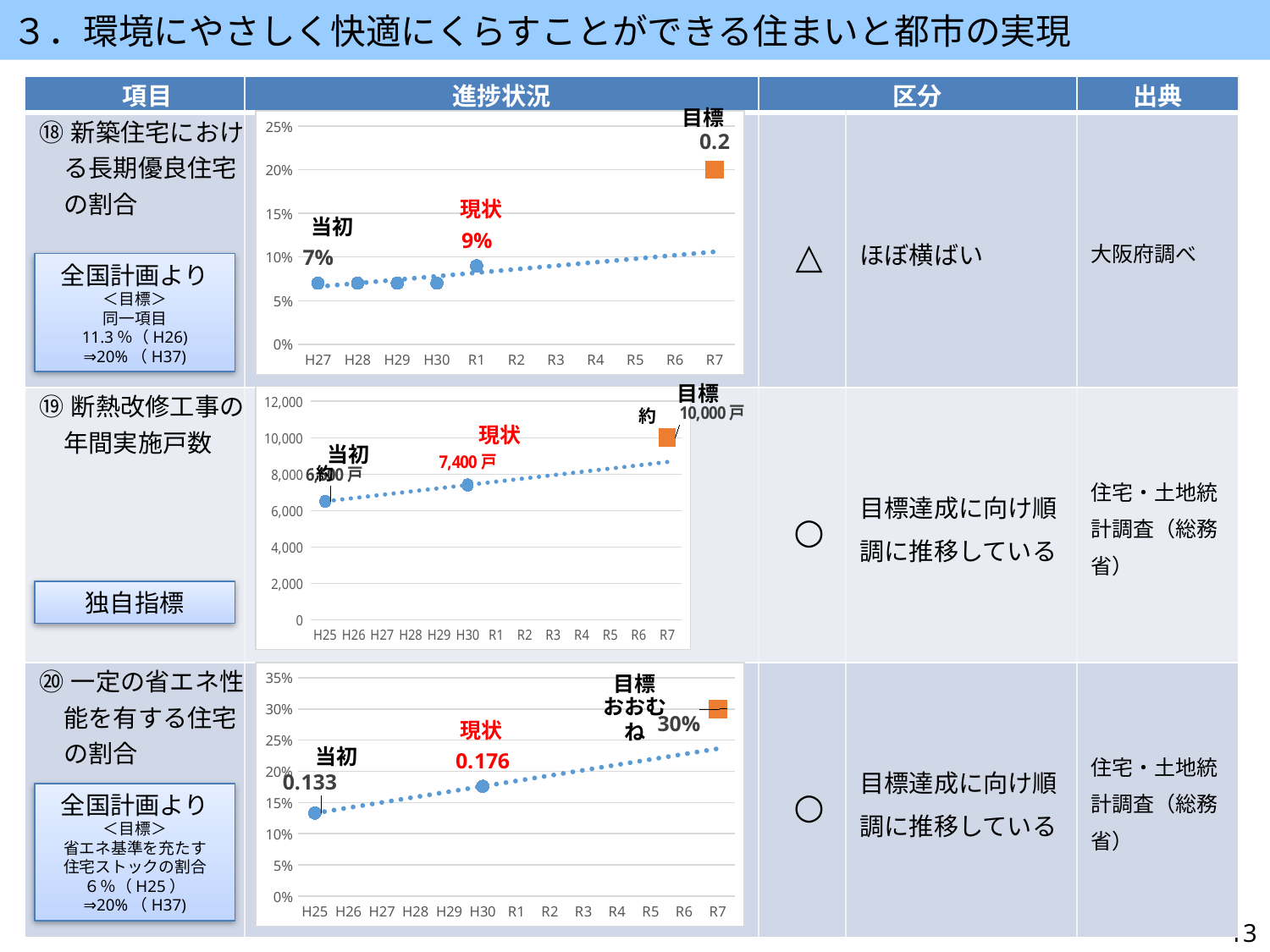
In the top chart (⑱ 新築住宅における長期優良住宅の割合), how many categories are shown on the x axis? 11 In the top chart (⑱ 新築住宅における長期優良住宅の割合), what value is printed next to the 目標 marker? 0.2 In the bottom chart (⑳ 一定の省エネ性能を有する住宅の割合), what is the value labelled 現状? 0.176 In the top chart (⑱ 新築住宅における長期優良住宅の割合), what is the value labelled 当初? 7% In the bottom chart (⑳ 一定の省エネ性能を有する住宅の割合), what is the value labelled 当初? 0.133 In the middle chart (⑲ 断熱改修工事の年間実施戸数), what is the 目標 value? 約10,000戸 In the top chart (⑱ 新築住宅における長期優良住宅の割合), what is the difference between the 現状 value and the 当初 value? 2% In the bottom chart (⑳ 一定の省エネ性能を有する住宅の割合), do the plotted values rise or fall from H25 to R7? rise In the middle chart (⑲ 断熱改修工事の年間実施戸数), what is the value labelled 現状? 7,400戸 In the top chart (⑱ 新築住宅における長期優良住宅の割合), what is the value labelled 現状? 9% In the top chart (⑱ 新築住宅における長期優良住宅の割合), is the 目標 marker at R7 greater or less than 15%? greater In the middle chart (⑲ 断熱改修工事の年間実施戸数), how many categories are shown on the x axis? 13